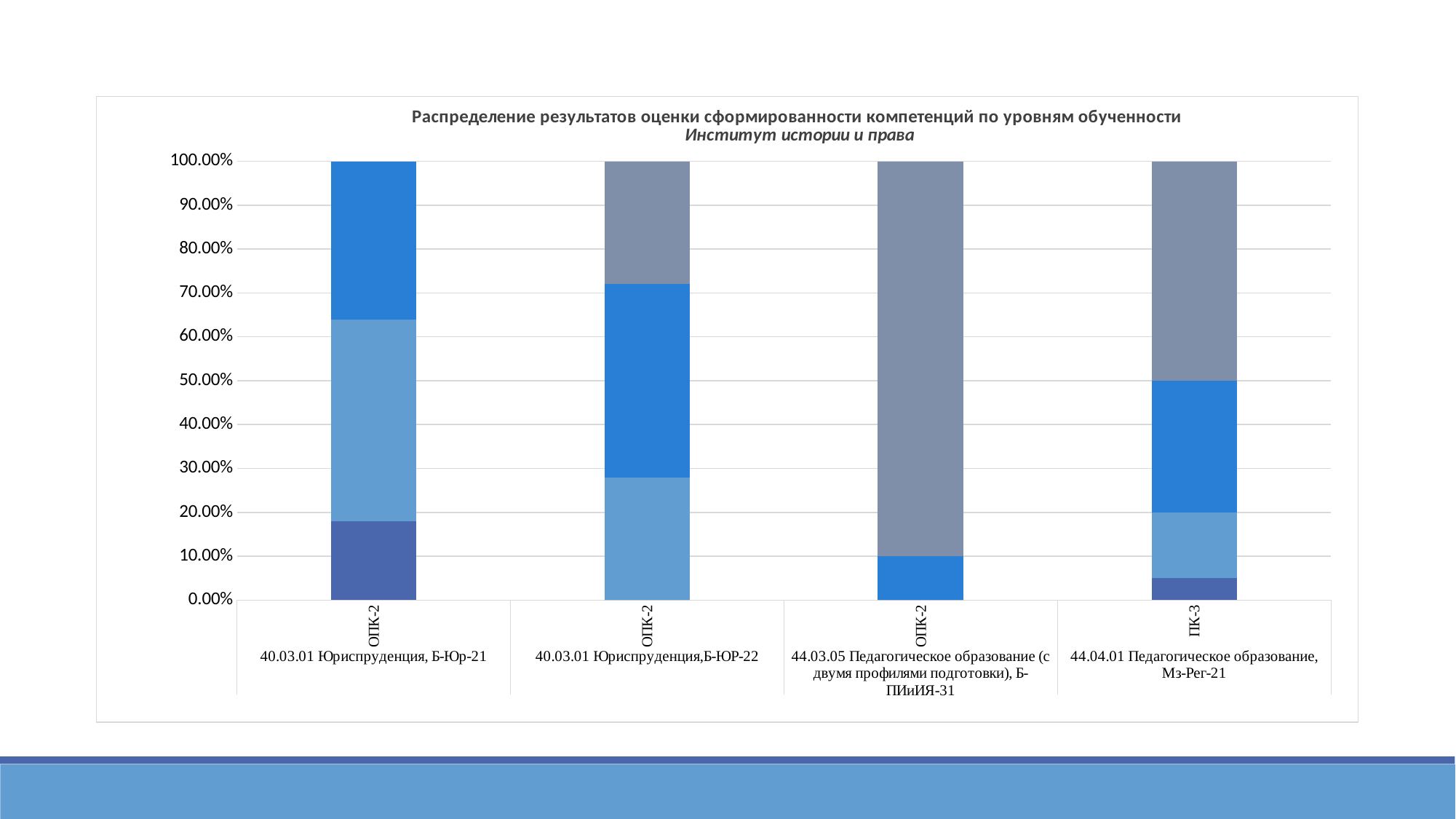
What kind of chart is shown on the slide? stacked bar chart Is the medium blue segment larger for 40.03.01 Юриспруденция,Б-ЮР-22 or for 44.03.05 Педагогическое образование (с двумя профилями подготовки), Б-ПИиИЯ-31? 40.03.01 Юриспруденция,Б-ЮР-22 At what value on the axis does the grey segment begin for 44.04.01 Педагогическое образование, Мз-Рег-21? 50.00% How many bars (programme groups) are plotted on the chart? 4 What is the total height of the stacked bar for 40.03.01 Юриспруденция, Б-Юр-21? 100.00% Is the dark blue bottom segment for 40.03.01 Юриспруденция, Б-Юр-21 greater or less than 30%? less Which bar has the largest grey segment? 44.03.05 Педагогическое образование (с двумя профилями подготовки), Б-ПИиИЯ-31 What is the title of the chart? Распределение результатов оценки сформированности компетенций по уровням обученности Which competency code is shown under the bar for 44.04.01 Педагогическое образование, Мз-Рег-21? ПК-3 At what value on the axis does the grey segment begin for 44.03.05 Педагогическое образование (с двумя профилями подготовки), Б-ПИиИЯ-31? 10.00% Is the grey segment for 44.03.05 Педагогическое образование (с двумя профилями подготовки), Б-ПИиИЯ-31 greater or less than 80%? greater